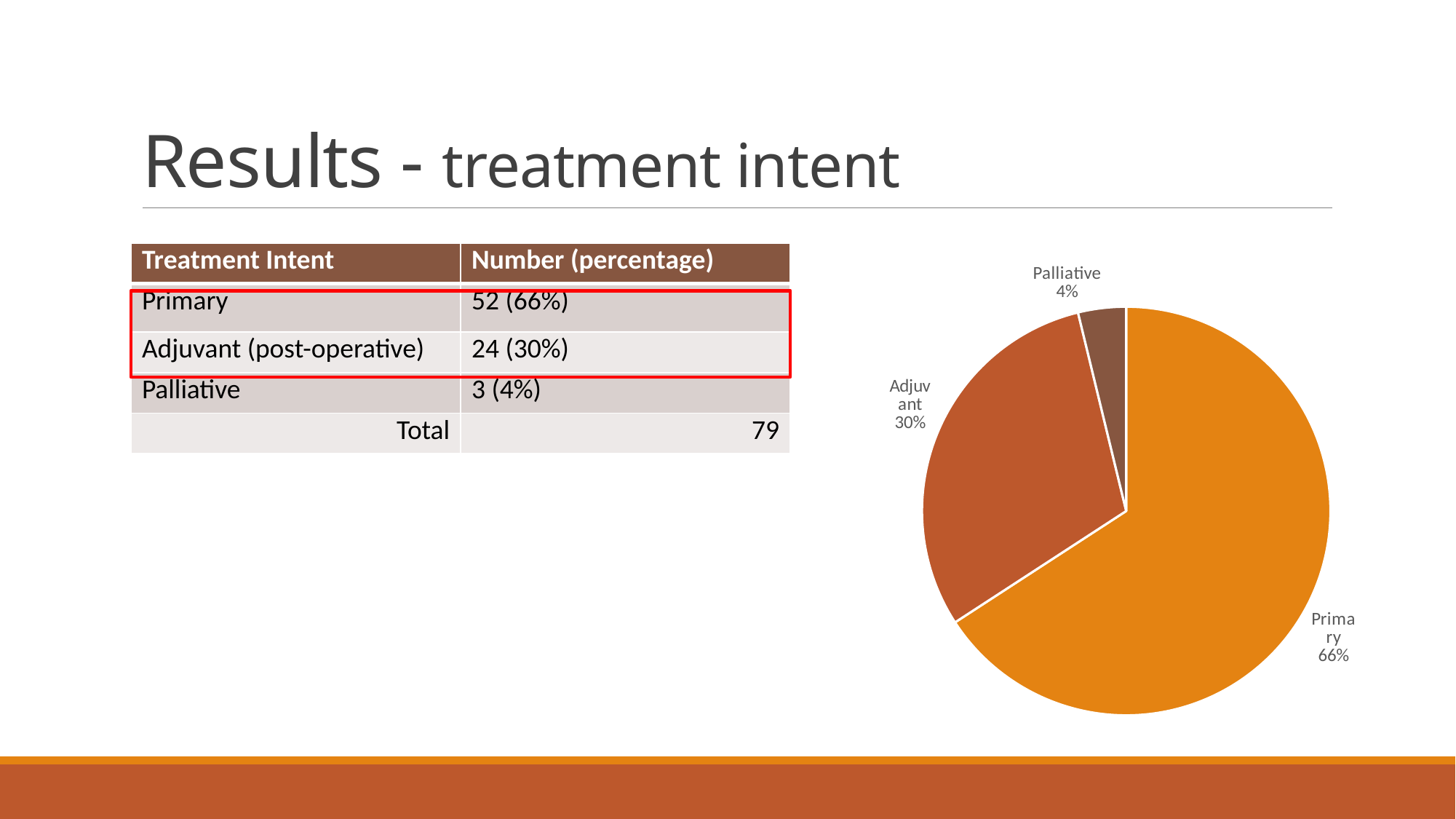
How many slices does the pie chart have? 3 What kind of chart is shown on the slide? pie chart Is the Primary slice of the pie chart more or less than half of the pie? more Which slice of the pie chart is the largest? Primary What is the difference in percentage points between the Adjuvant and Palliative slices of the pie chart? 26 Which slice of the pie chart is larger, Adjuvant or Palliative? Adjuvant Which slice of the pie chart is the smallest? Palliative What percentage does the Palliative slice of the pie chart show? 4% What is the difference in percentage points between the Primary and Adjuvant slices of the pie chart? 36 What colour is the Primary slice of the pie chart? orange What percentage does the Primary slice of the pie chart show? 66% What percentage does the Adjuvant slice of the pie chart show? 30%